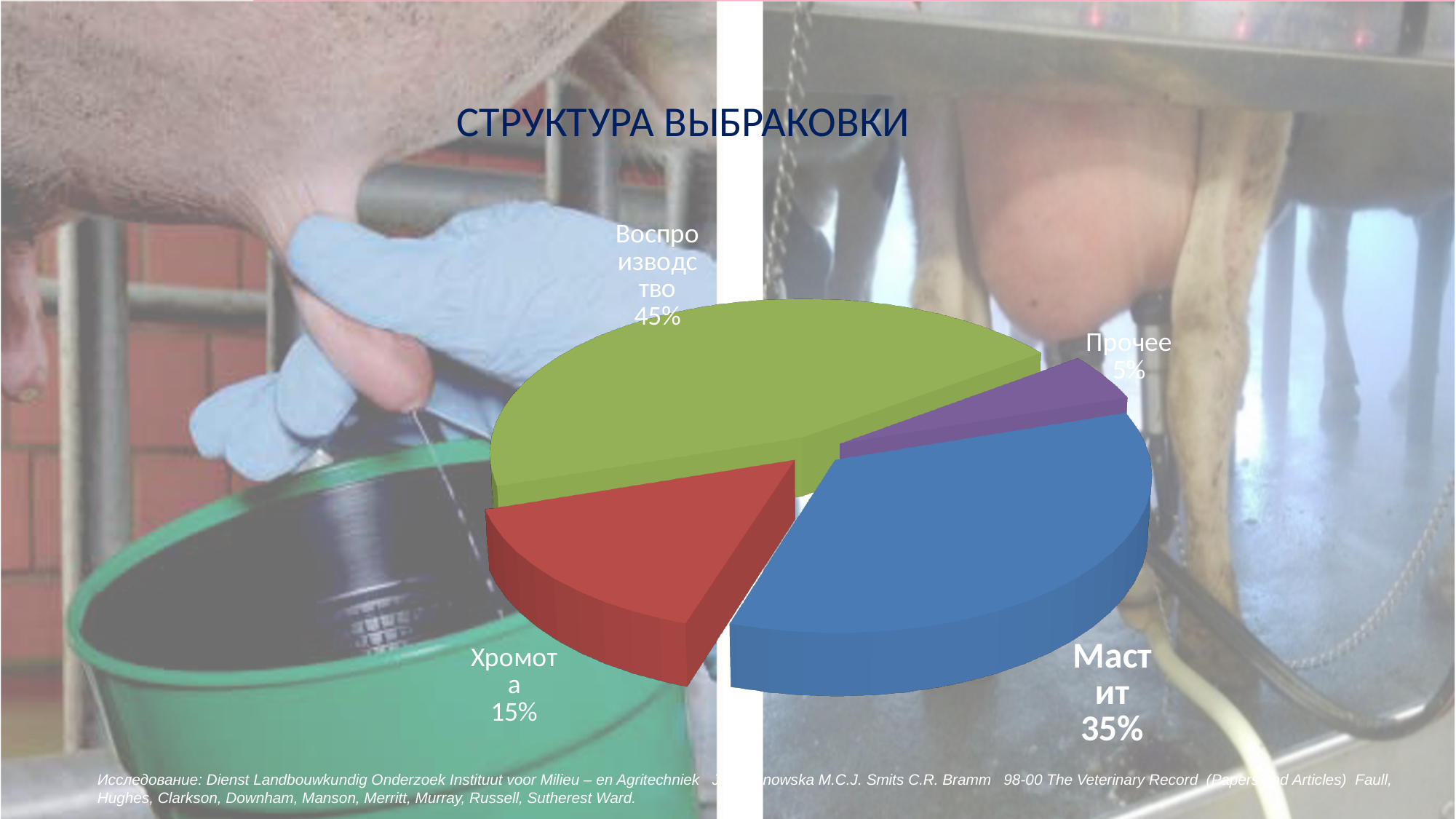
What kind of chart is shown on the slide? Pie chart What is the difference in percentage points between Воспроизводство and Мастит? 10% Which category has the largest slice of the pie? Воспроизводство Which category has the smallest slice of the pie? Прочее What colour is the slice for Мастит? Blue How many slices does the pie chart have? 4 What share of the pie does Прочее account for? 5% What share of the pie does Воспроизводство account for? 45% What share of the pie does Мастит account for? 35% Which is larger, the share for Хромота or the share for Прочее? Хромота What is the title of the chart? СТРУКТУРА ВЫБРАКОВКИ